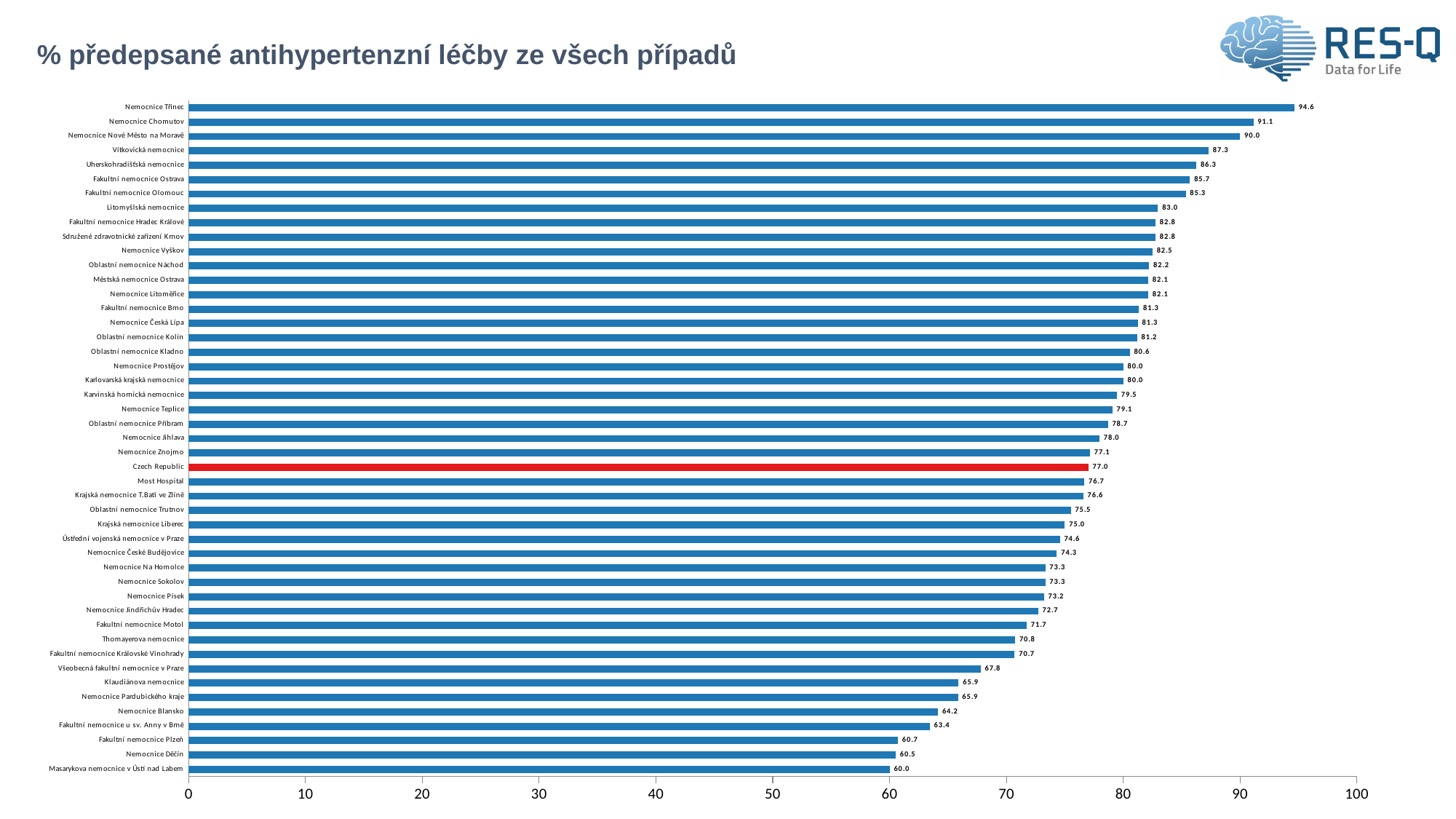
What is the value for Fakultní nemocnice Motol? 71.7 What kind of chart is shown on the slide? bar chart Which hospital has the lowest value? Masarykova nemocnice v Ústí nad Labem What is the value for Czech Republic? 77.0 How many bars are shown in the chart? 47 Which bar is coloured red instead of blue? Czech Republic Which has a larger value, Fakultní nemocnice Ostrava or Fakultní nemocnice Plzeň? Fakultní nemocnice Ostrava Is the value for Nemocnice Blansko greater or less than 70? less Which hospital has the highest value? Nemocnice Třinec What is the title of the chart? % předepsané antihypertenzní léčby ze všech případů What is the difference between the values for Nemocnice Chomutov and Nemocnice Děčín? 30.6 What is the value for Nemocnice Třinec? 94.6